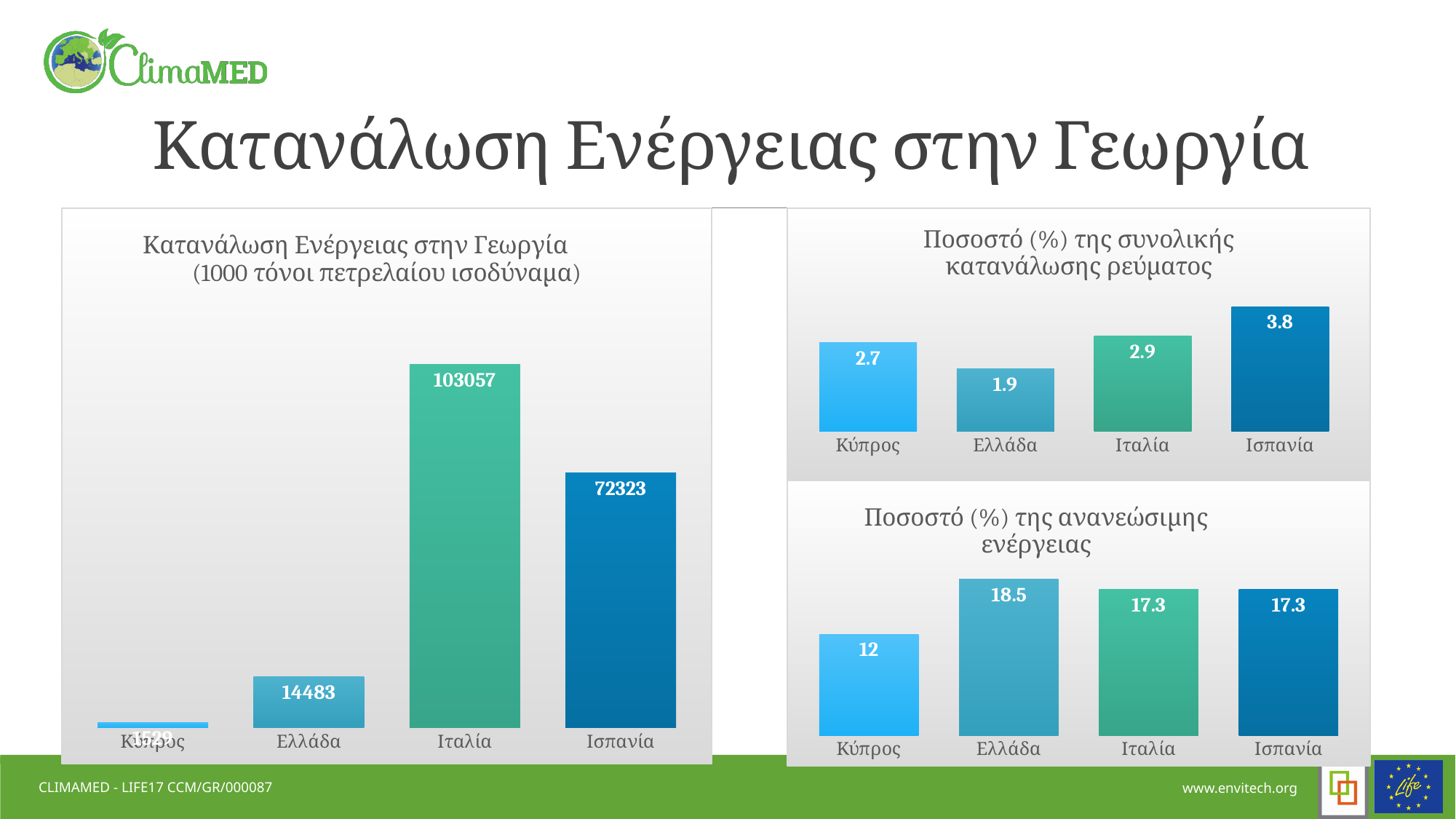
In the chart 'Ποσοστό (%) της συνολικής κατανάλωσης ρεύματος', what is the value for Κύπρος? 2.7 In the chart 'Κατανάλωση Ενέργειας στην Γεωργία (1000 τόνοι πετρελαίου ισοδύναμα)', which country has the highest value? Ιταλία In the chart 'Ποσοστό (%) της συνολικής κατανάλωσης ρεύματος', which country has the highest value? Ισπανία In the chart 'Ποσοστό (%) της συνολικής κατανάλωσης ρεύματος', which country has the lowest value? Ελλάδα In the chart 'Ποσοστό (%) της ανανεώσιμης ενέργειας', what is the value for Ελλάδα? 18.5 In the chart 'Κατανάλωση Ενέργειας στην Γεωργία (1000 τόνοι πετρελαίου ισοδύναμα)', what is the value for Ιταλία? 103057 In the chart 'Κατανάλωση Ενέργειας στην Γεωργία (1000 τόνοι πετρελαίου ισοδύναμα)', what is the value for Ελλάδα? 14483 In the chart 'Κατανάλωση Ενέργειας στην Γεωργία (1000 τόνοι πετρελαίου ισοδύναμα)', which country has the lowest value? Κύπρος In the chart 'Ποσοστό (%) της συνολικής κατανάλωσης ρεύματος', what is the difference between the values for Ισπανία and Ελλάδα? 1.9 In the chart 'Κατανάλωση Ενέργειας στην Γεωργία (1000 τόνοι πετρελαίου ισοδύναμα)', what is the difference between the values for Ιταλία and Ισπανία? 30734 How many charts are shown on the slide? 3 In the chart 'Ποσοστό (%) της ανανεώσιμης ενέργειας', which country has the lowest value? Κύπρος